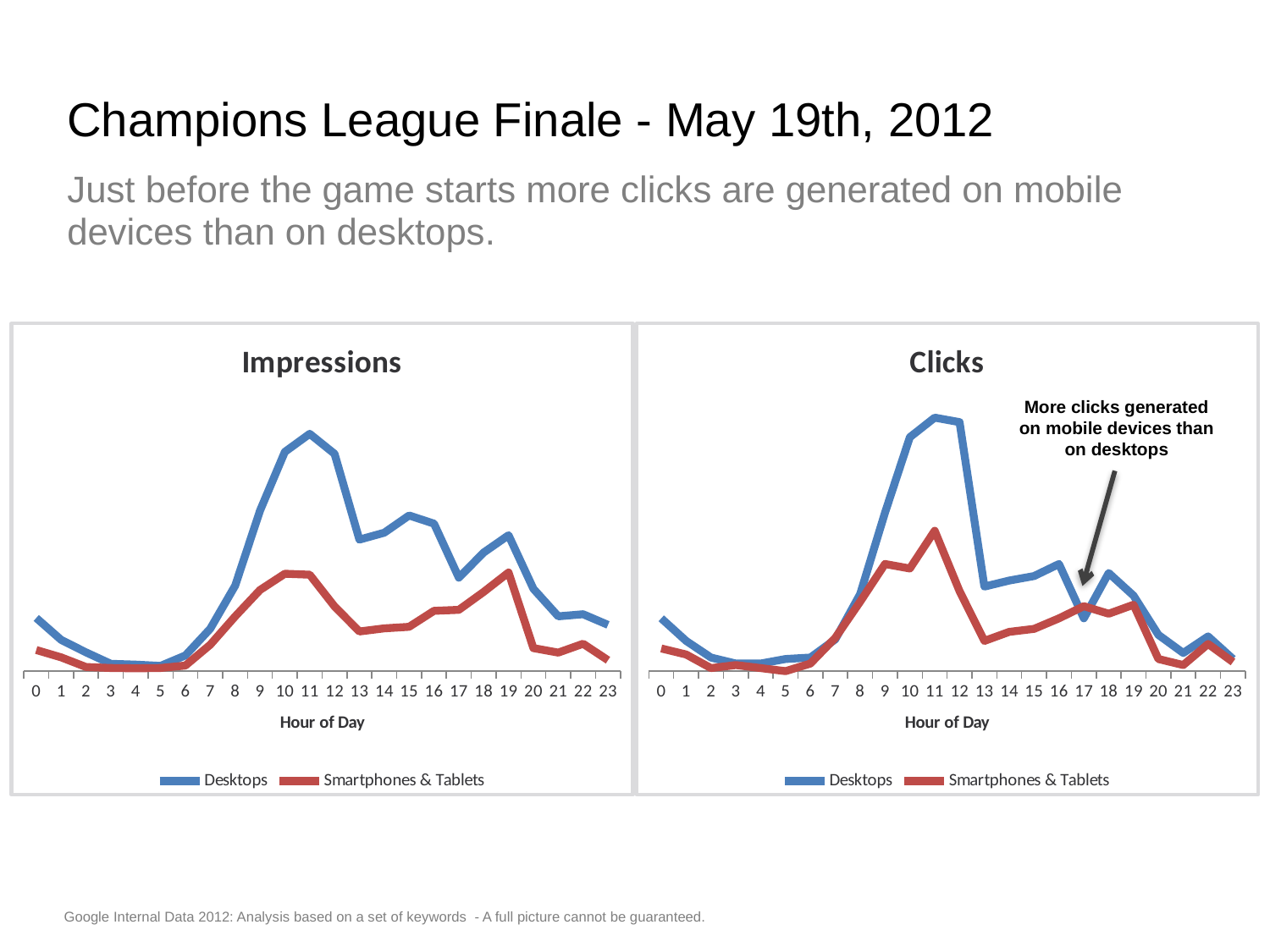
How many series does the legend of the Clicks chart list? 2 In the Impressions chart, at hour 11, which series is larger: Desktops or Smartphones & Tablets? Desktops In the Clicks chart, at hour 12, which series is larger: Desktops or Smartphones & Tablets? Desktops In the Clicks chart, does the Desktops series rise or fall between hour 6 and hour 11? rise What kind of chart is the Clicks chart? line chart What is the x-axis title of the Clicks chart? Hour of Day How many hours are plotted along the x axis of the Impressions chart? 24 In the Impressions chart, at which hour of day does the Desktops series reach its highest value? 11 What kind of chart is the Impressions chart? line chart In the Clicks chart, at which hour of day does the Smartphones & Tablets series reach its highest value? 11 In the Impressions chart, does the Desktops series rise or fall between hour 11 and hour 13? fall In the Clicks chart, at which hour of day does the Desktops series reach its highest value? 11